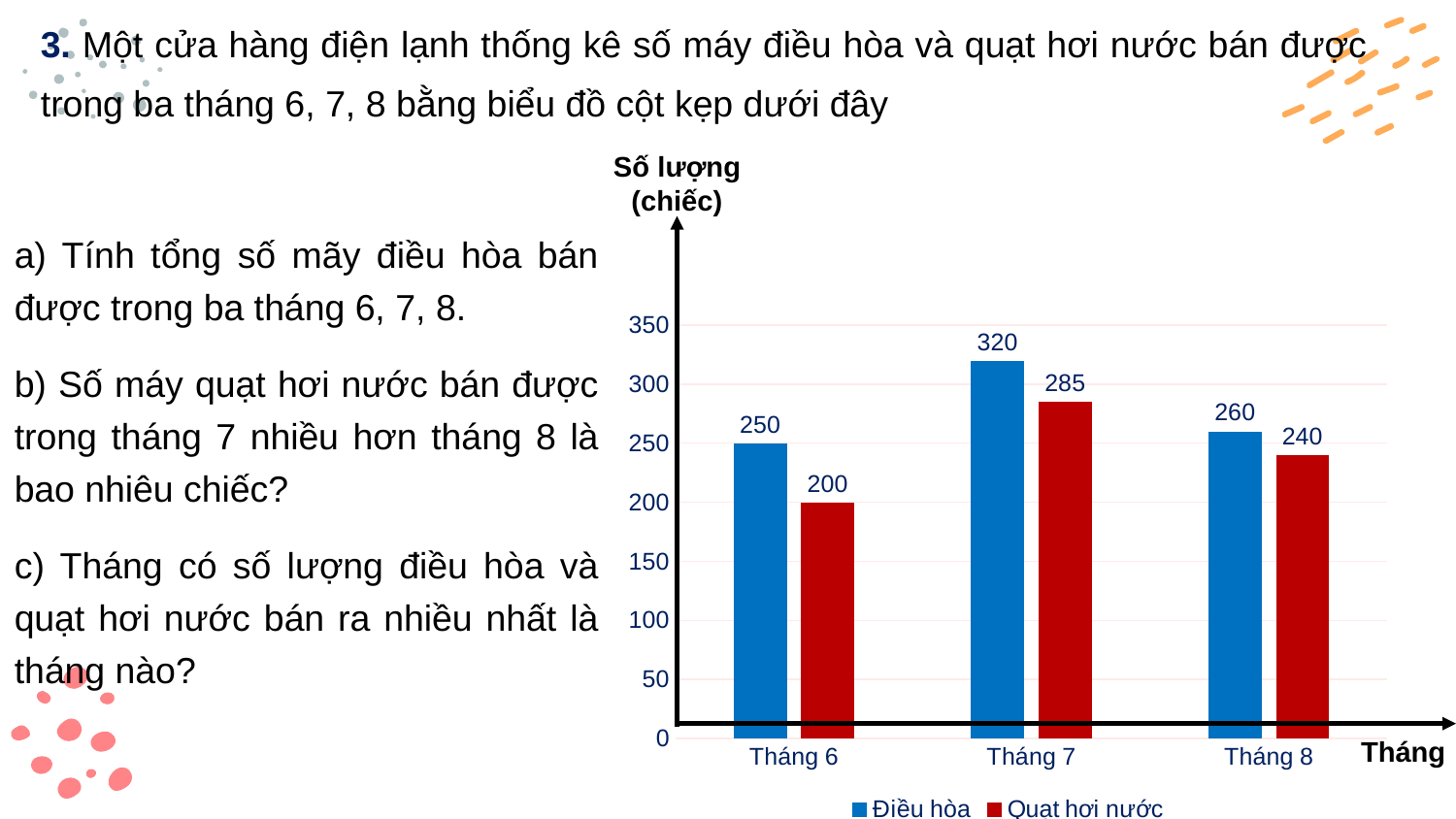
What is the label of the vertical axis? Số lượng (chiếc) Which month has the highest value for Điều hòa? Tháng 7 How many series does the legend list? 2 What is the difference between Quạt hơi nước in Tháng 7 and Tháng 8? 45 What is the value for Quạt hơi nước in Tháng 6? 200 How many months are shown on the x axis? 3 What kind of chart is shown? bar chart Which is larger: Điều hòa in Tháng 8 or Quạt hơi nước in Tháng 7? Quạt hơi nước in Tháng 7 What is the value for Quạt hơi nước in Tháng 8? 240 What is the value for Điều hòa in Tháng 7? 320 Which month has the lowest value for Quạt hơi nước? Tháng 6 What is the total of Điều hòa across Tháng 6, Tháng 7 and Tháng 8? 830